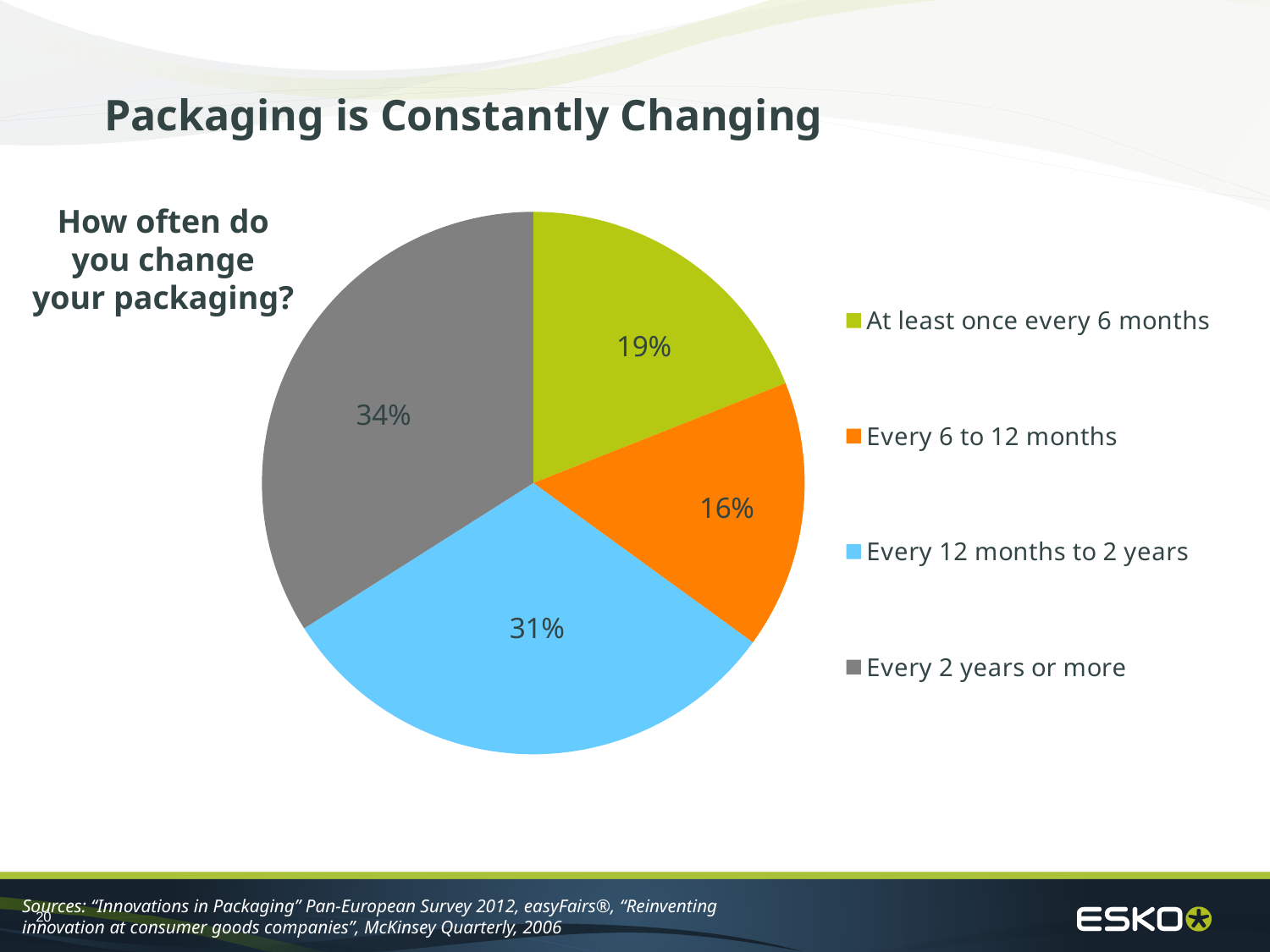
What kind of chart is shown on the slide? Pie chart What share of respondents change their packaging at least once every 6 months? 19% Which is larger: the share for 'At least once every 6 months' or for 'Every 6 to 12 months'? At least once every 6 months What share of respondents change their packaging every 2 years or more? 34% How many categories does the pie chart show? 4 Which response has the smallest share of the pie? Every 6 to 12 months Which response has the largest share of the pie? Every 2 years or more What colour is the slice for 'Every 12 months to 2 years'? Light blue What share of respondents change their packaging every 12 months to 2 years? 31% What is the difference in percentage points between 'Every 2 years or more' and 'Every 6 to 12 months'? 18 What question does the pie chart answer, according to the label to its left? How often do you change your packaging? What share of respondents change their packaging every 6 to 12 months? 16%